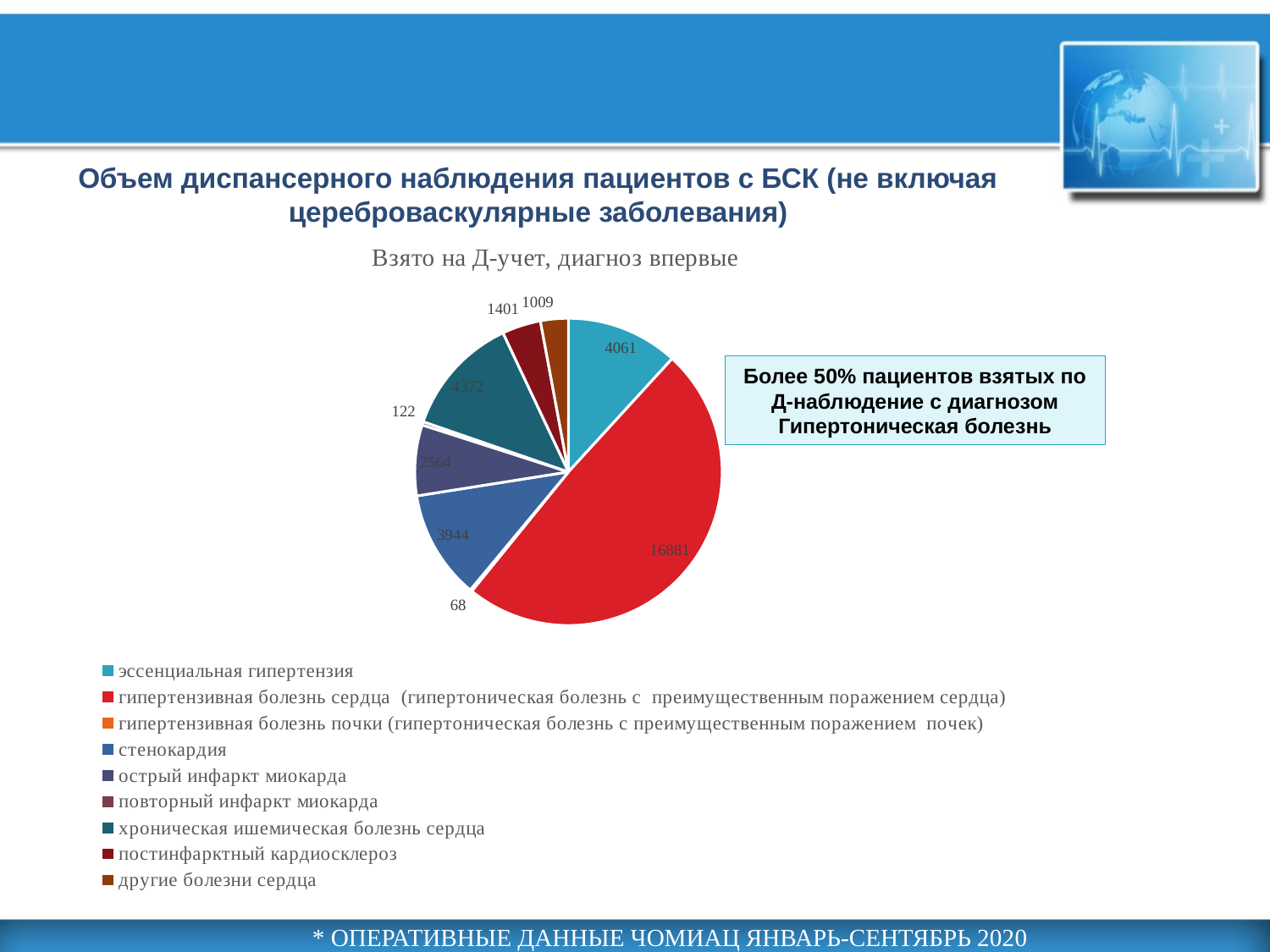
What kind of chart is shown on the slide? pie chart What is the value for стенокардия in the pie chart? 3944 What is the difference between the values for хроническая ишемическая болезнь сердца and эссенциальная гипертензия? 311 What is the value for эссенциальная гипертензия in the pie chart? 4061 What is the value for гипертензивная болезнь сердца in the pie chart? 16881 How many categories does the legend of the pie chart list? 9 Which is larger: the value for стенокардия or the value for острый инфаркт миокарда? стенокардия What is the value for острый инфаркт миокарда in the pie chart? 2564 What is the value for хроническая ишемическая болезнь сердца in the pie chart? 4372 What is the smallest value labelled on the pie chart? 68 What is the title of the pie chart? Взято на Д-учет, диагноз впервые Which category has the largest slice in the pie chart? гипертензивная болезнь сердца